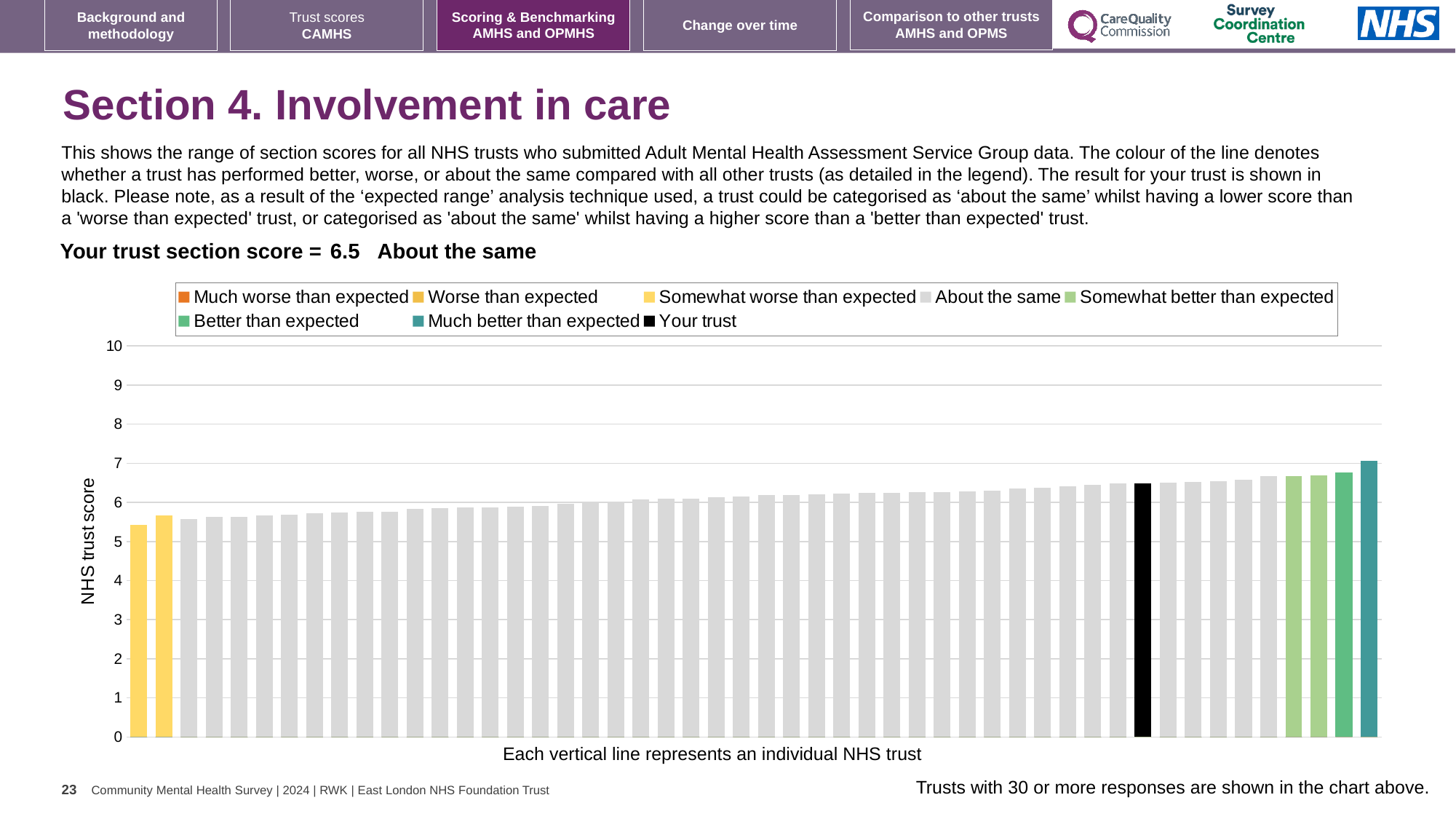
Is the value of the lowest bar in the chart greater or less than 6? less What kind of chart is shown on the slide? bar chart How many entries does the chart legend list? 8 How many bars in the chart are coloured black (Your trust)? 1 Do the bar values rise or fall from left to right across the chart? rise What is the label on the vertical axis of the chart? NHS trust score Which legend category does the tallest (rightmost) bar belong to, based on its colour? Much better than expected Which category is your trust placed in according to the text above the chart? About the same Is the value of the lowest bar in the chart greater or less than 5? greater Is the value for your trust (the black bar) greater or less than 6? greater What is the section score for your trust shown on the slide? 6.5